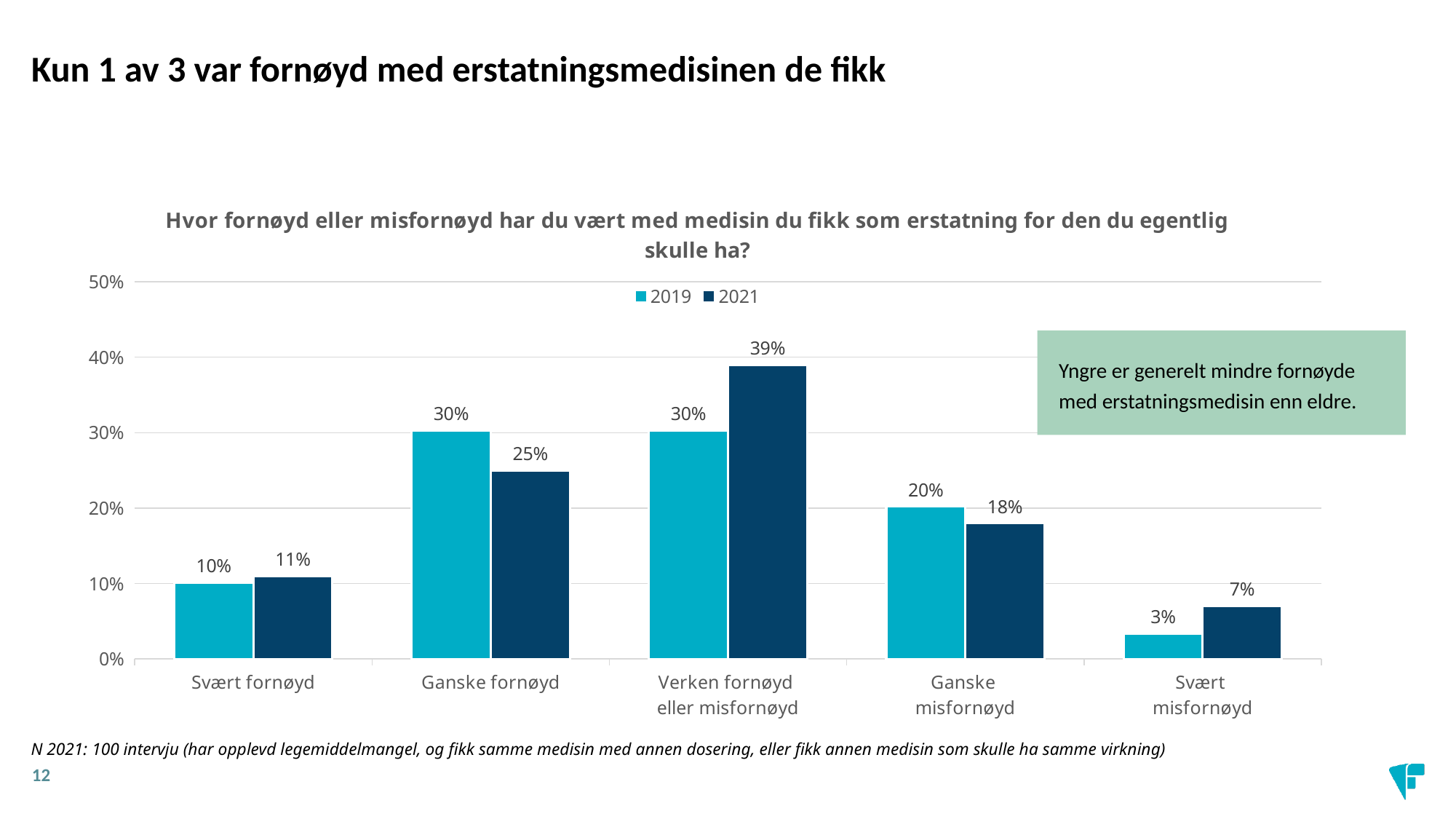
Which category has the highest 2021 value? Verken fornøyd eller misfornøyd Which is larger for "Verken fornøyd eller misfornøyd": the 2019 value or the 2021 value? 2021 How many series does the legend list? 2 Which category has the lowest 2019 value? Svært misfornøyd What is the 2021 value for "Svært misfornøyd"? 7% What is the difference between the 2019 and 2021 values for "Ganske fornøyd"? 5% Which series is shown in dark blue? 2021 What is the 2019 value for "Ganske misfornøyd"? 20% Is the 2021 value for "Ganske fornøyd" greater or less than 30%? less What is the 2021 value for "Verken fornøyd eller misfornøyd"? 39% What kind of chart is shown on the slide? Bar chart How many categories are shown on the x axis? 5